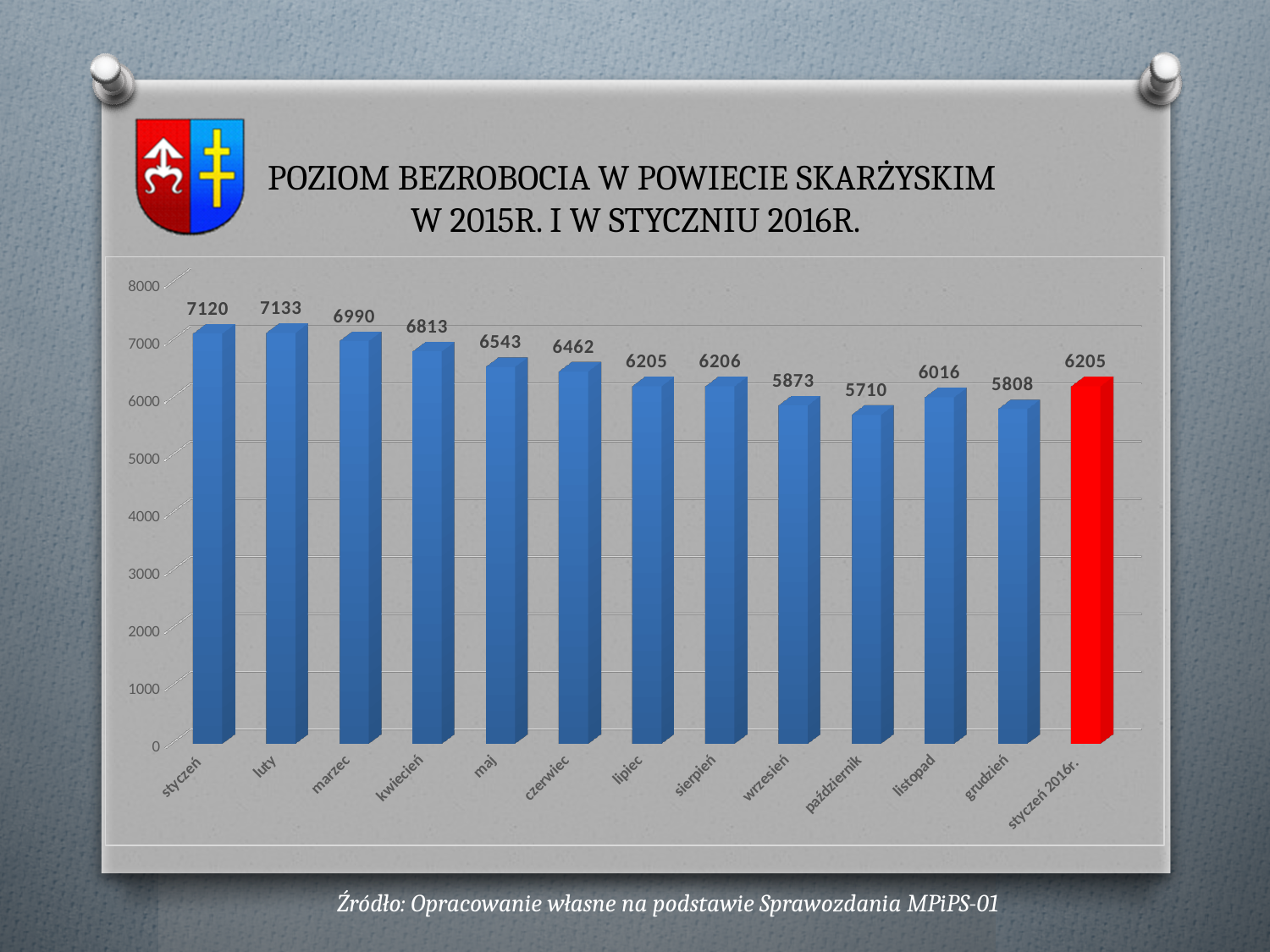
What is the difference between the values for kwiecień and maj? 270 What is the unemployment value for marzec? 6990 How many bars are shown on the chart? 13 What is the value shown for październik? 5710 Which is larger, the value for listopad or the value for grudzień? listopad What is the value for styczeń 2016r.? 6205 Which bar is coloured red instead of blue? styczeń 2016r. Which month has the highest value on the chart? luty Which month has the lowest value on the chart? październik What kind of chart is shown on the slide? bar chart Is the value for wrzesień greater or less than 6000? less What is the difference between the values for styczeń and luty? 13